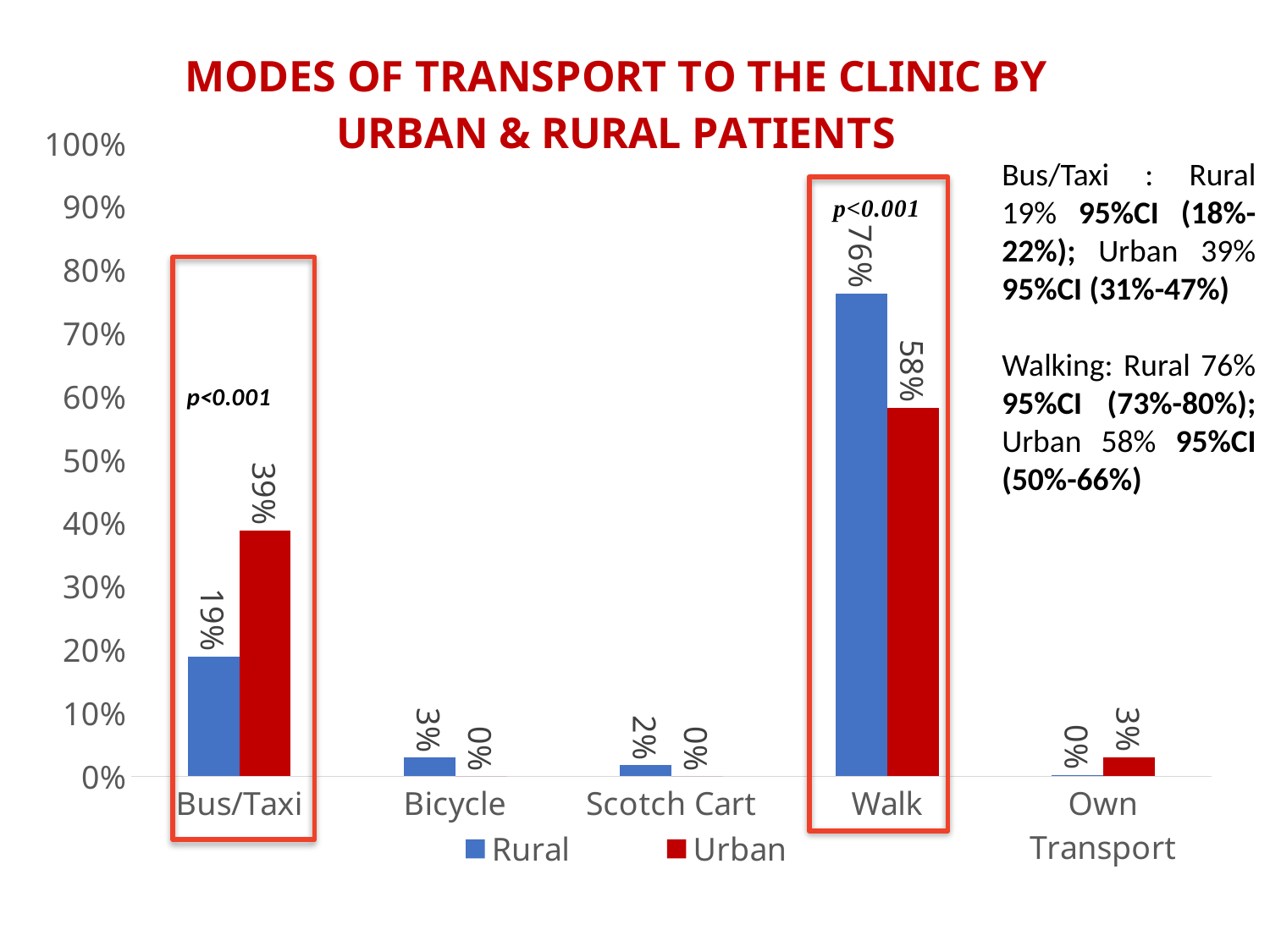
What is the Urban value for Own Transport? 3% Which colour represents the Urban series? Red Which mode of transport has the highest Rural value? Walk What is the Rural value for Bus/Taxi? 19% What kind of chart is shown on the slide? Bar chart How many modes of transport are shown on the x axis? 5 What is the difference between the Urban and Rural values for Bus/Taxi? 20% Which mode of transport has the lowest Rural value? Own Transport How many series does the legend list? 2 What is the difference between the Rural and Urban values for Walk? 18% What is the Urban value for Walk? 58% Which is larger for Bus/Taxi, the Rural value or the Urban value? Urban